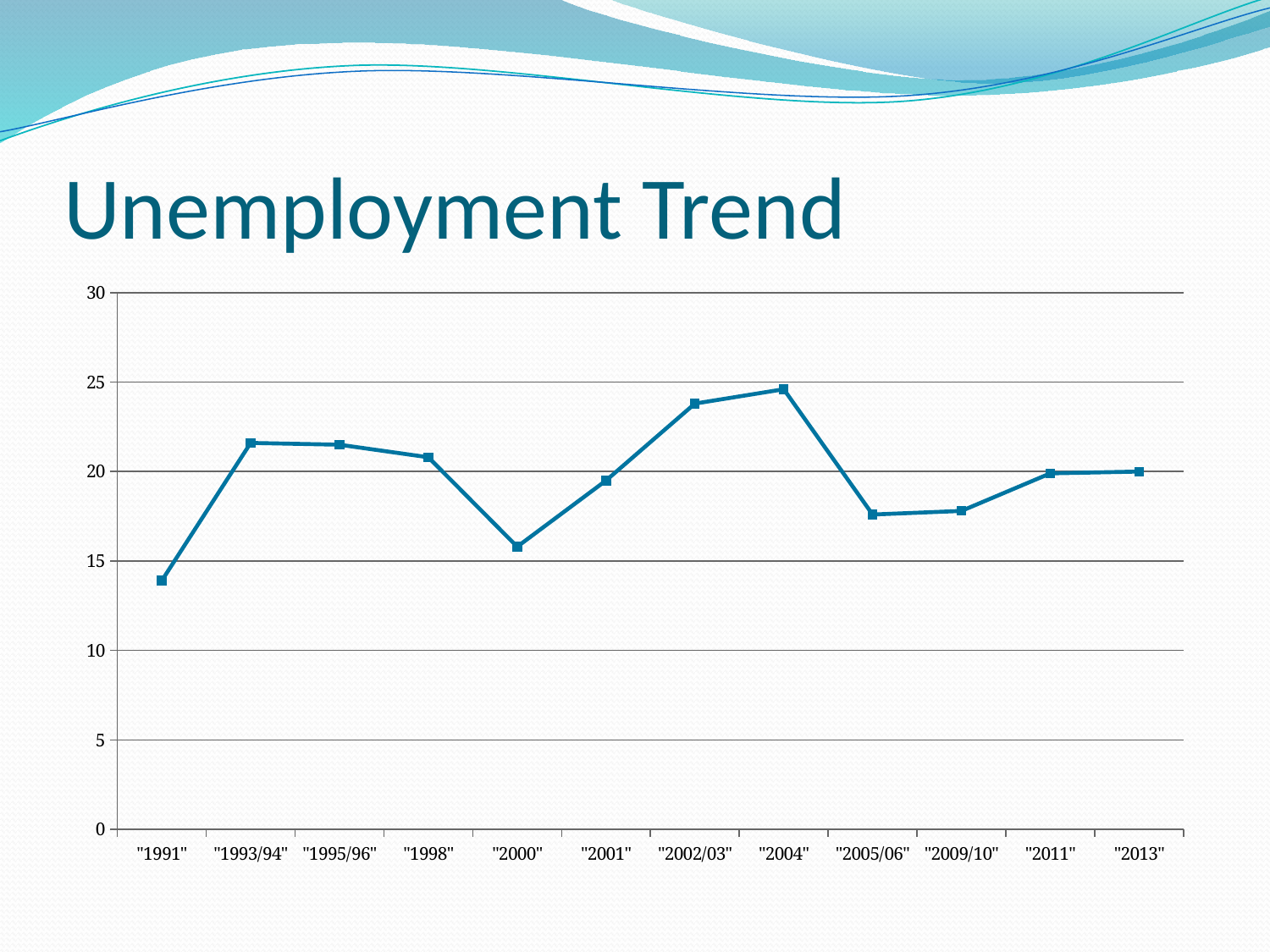
What is the highest value shown on the vertical axis? 30 Which year has the lowest value on the chart? 1991 What kind of chart is shown on the slide? line chart Is the value for 2002/03 greater or less than 20? greater What is the title of the slide's chart? Unemployment Trend Which is larger, the value for 1991 or the value for 2000? 2000 Is the value for 2005/06 greater or less than 20? less Which year has the highest value on the chart? 2004 Is the value for 2004 greater or less than 25? less Does the value rise or fall from 2004 to 2005/06? fall How many data points are plotted on the line? 12